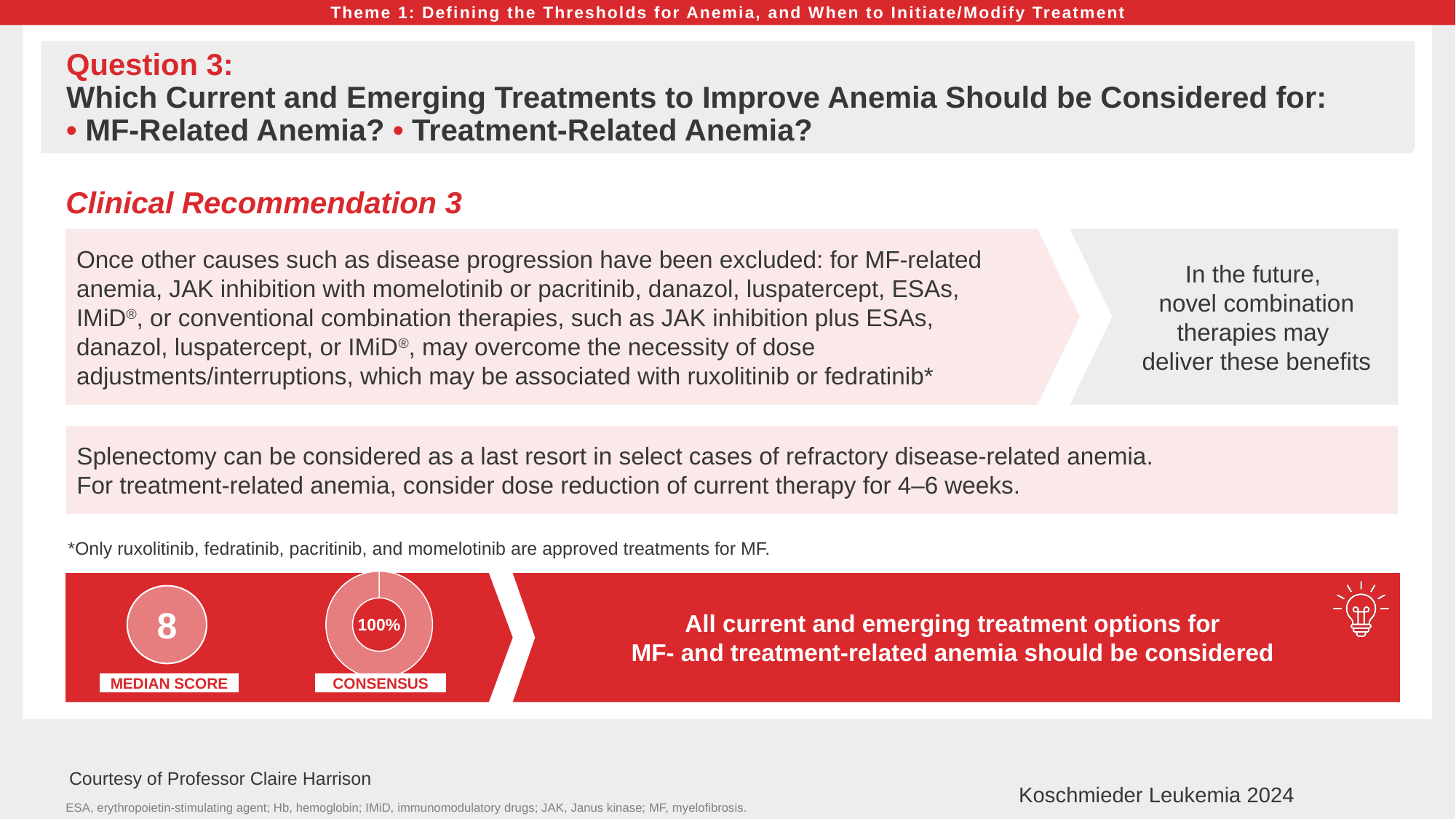
What label appears beneath the donut chart? CONSENSUS What label appears beneath the circle showing the value 8? MEDIAN SCORE What is the median score shown next to the consensus chart? 8 What percentage is shown in the centre of the consensus donut chart? 100% Is the consensus value shown in the donut chart greater or less than 50%? greater What kind of chart is used to display the consensus value? Donut (pie) chart What share of the consensus donut chart is filled? 100%